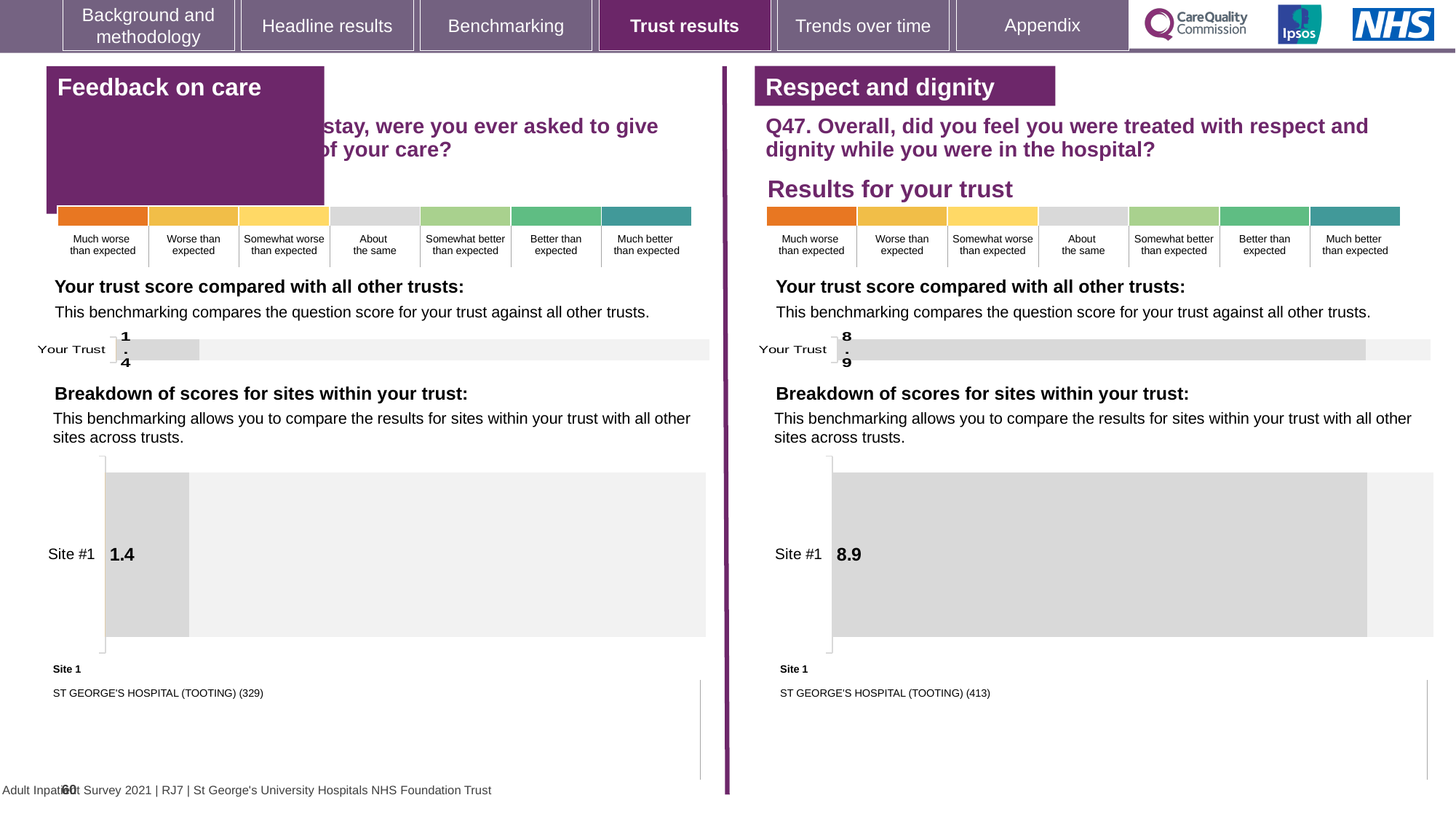
Which site is listed as Site 1 beneath the 'Breakdown of scores' chart on the right-hand 'Respect and dignity' section? ST GEORGE'S HOSPITAL (TOOTING) (413) How many sites are shown in the 'Breakdown of scores for sites within your trust' chart on the left-hand 'Feedback on care' section? 1 What is the difference between the Site #1 score in the right-hand 'Respect and dignity' chart and the Site #1 score in the left-hand 'Feedback on care' chart? 7.5 In the 'Breakdown of scores for sites within your trust' chart on the left-hand 'Feedback on care' section, what is the value for Site #1? 1.4 On the left-hand 'Feedback on care' section, what is the score shown for 'Your Trust'? 1.4 Which is larger: the Site #1 score in the left-hand 'Feedback on care' chart or the Site #1 score in the right-hand 'Respect and dignity' chart? Respect and dignity (8.9) In the 'Breakdown of scores for sites within your trust' chart on the right-hand 'Respect and dignity' section, what is the value for Site #1? 8.9 On the right-hand 'Respect and dignity' section, what is the score shown for 'Your Trust'? 8.9 How many sites are shown in the 'Breakdown of scores for sites within your trust' chart on the right-hand 'Respect and dignity' section? 1 What kind of chart is used to show the Site #1 score on the right-hand 'Respect and dignity' section? Bar chart Which site is listed as Site 1 beneath the 'Breakdown of scores' chart on the left-hand 'Feedback on care' section? ST GEORGE'S HOSPITAL (TOOTING) (329) Is the 'Your Trust' score on the left-hand 'Feedback on care' section the same as its Site #1 score? Yes, both are 1.4